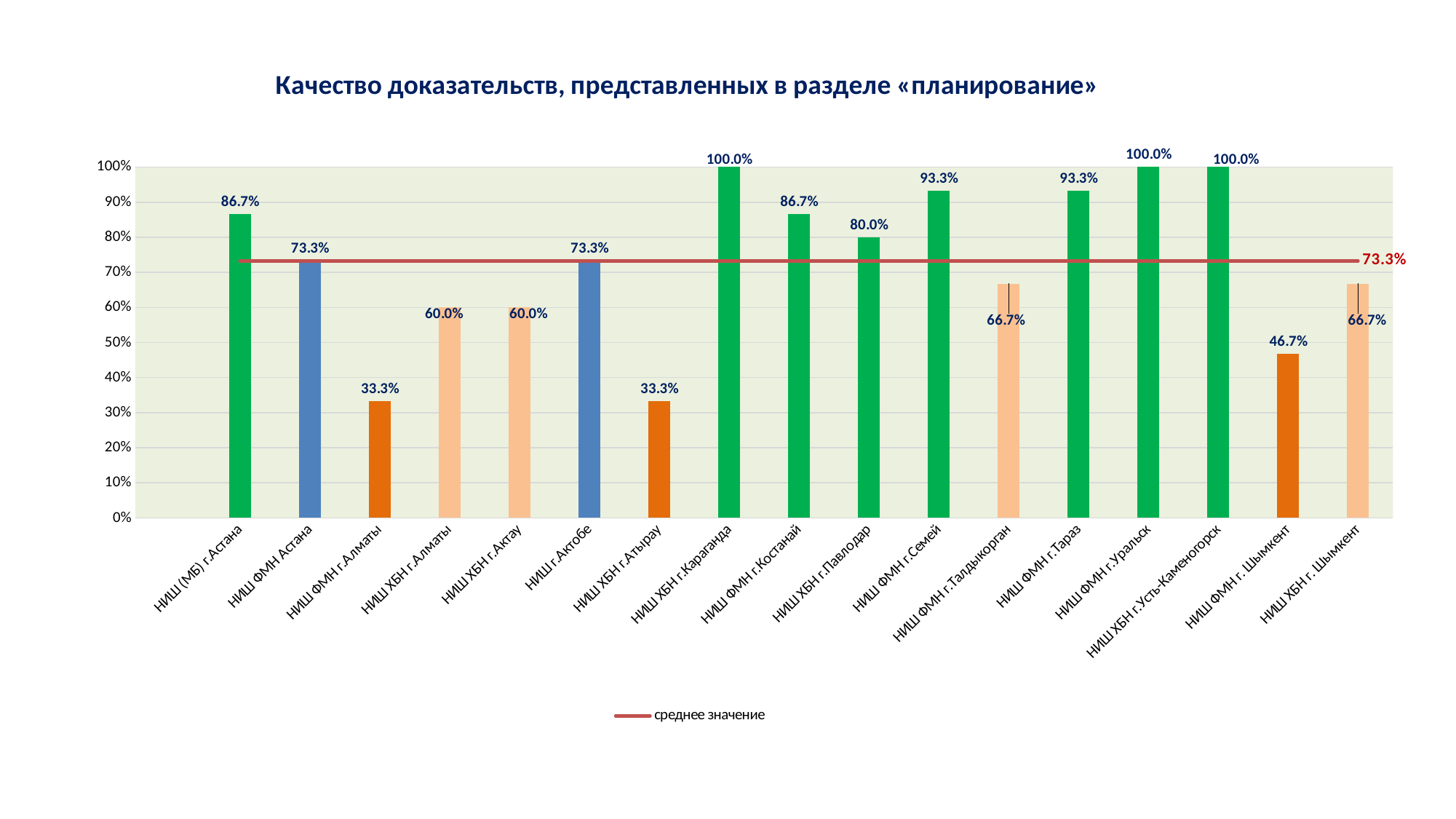
Which has a higher value, НИШ ФМН г.Костанай or НИШ ХБН г.Павлодар? НИШ ФМН г.Костанай How many schools have a value of 100.0%? 3 What is the difference between the values for НИШ ФМН г.Семей and НИШ ФМН г.Талдыкорган? 26.6% What value does the red average line (среднее значение) show? 73.3% What kind of chart is this? bar chart What is the lowest value shown among the bars? 33.3% What is the value for НИШ ХБН г.Павлодар? 80.0% Is the value for НИШ ХБН г.Актау greater or less than 70%? less What is the value for НИШ ФМН г.Талдыкорган? 66.7% What is the value for НИШ ФМН г. Шымкент? 46.7% How many schools (categories) are shown on the x axis? 17 What is the title of the chart? Качество доказательств, представленных в разделе «планирование»